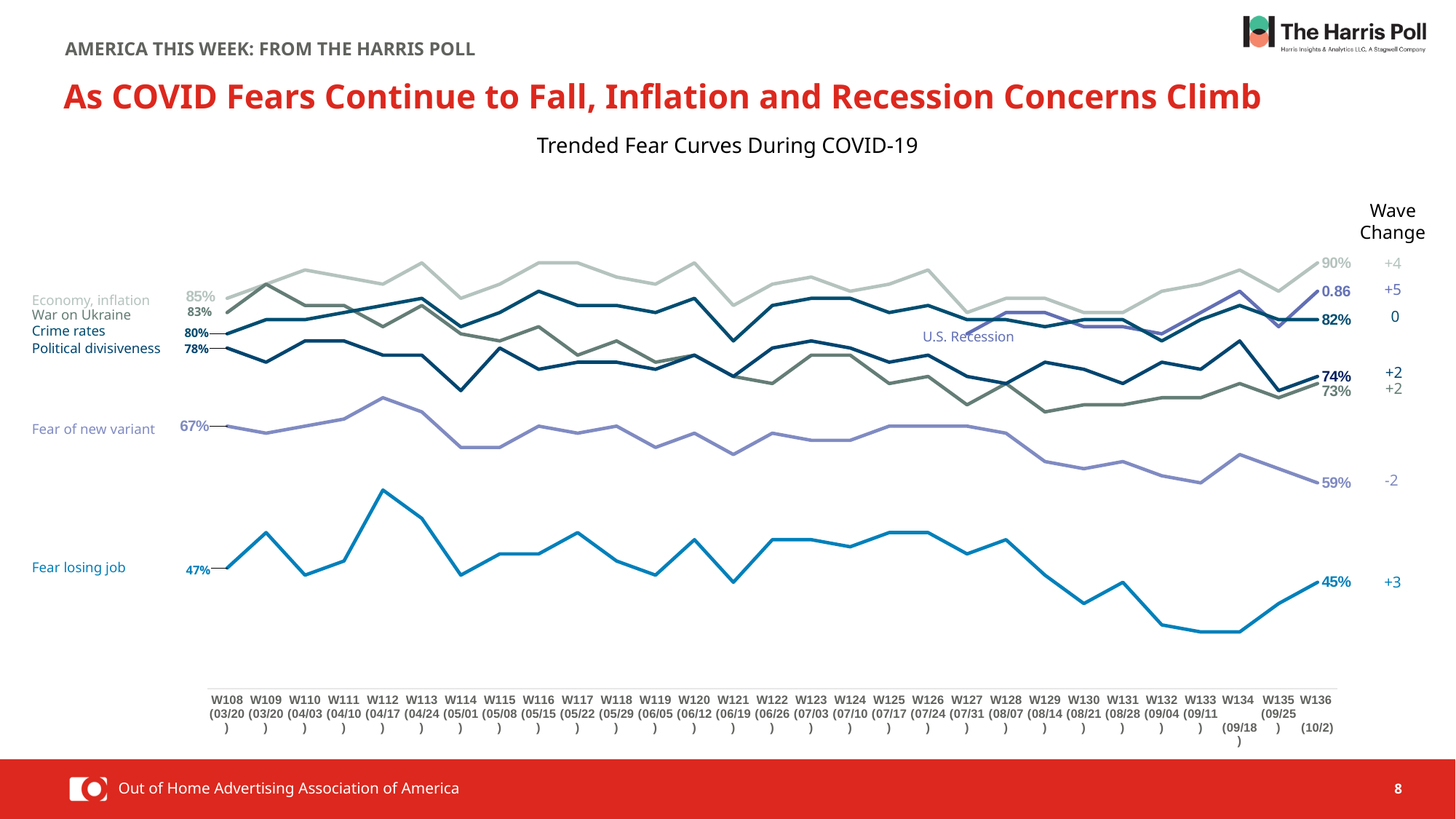
What is the Wave Change shown for U.S. Recession? +5 What is the title of the chart? Trended Fear Curves During COVID-19 What was the value for Fear losing job at W136 (10/2)? 45% Which series has the highest value at W136 (10/2)? Economy, inflation What was the value for Economy, inflation at W108 (03/20)? 85% By how many percentage points did Economy, inflation change from W108 (85%) to W136 (90%)? 5 percentage points What kind of chart is shown on the slide? Line chart Did Fear of new variant rise or fall between W108 and W136? Fall How many waves are shown on the x axis? 29 What was the value for Fear of new variant at W108 (03/20)? 67% Which series has the lowest value at W136 (10/2)? Fear losing job At W108 (03/20), which was higher: Crime rates or Political divisiveness? Crime rates